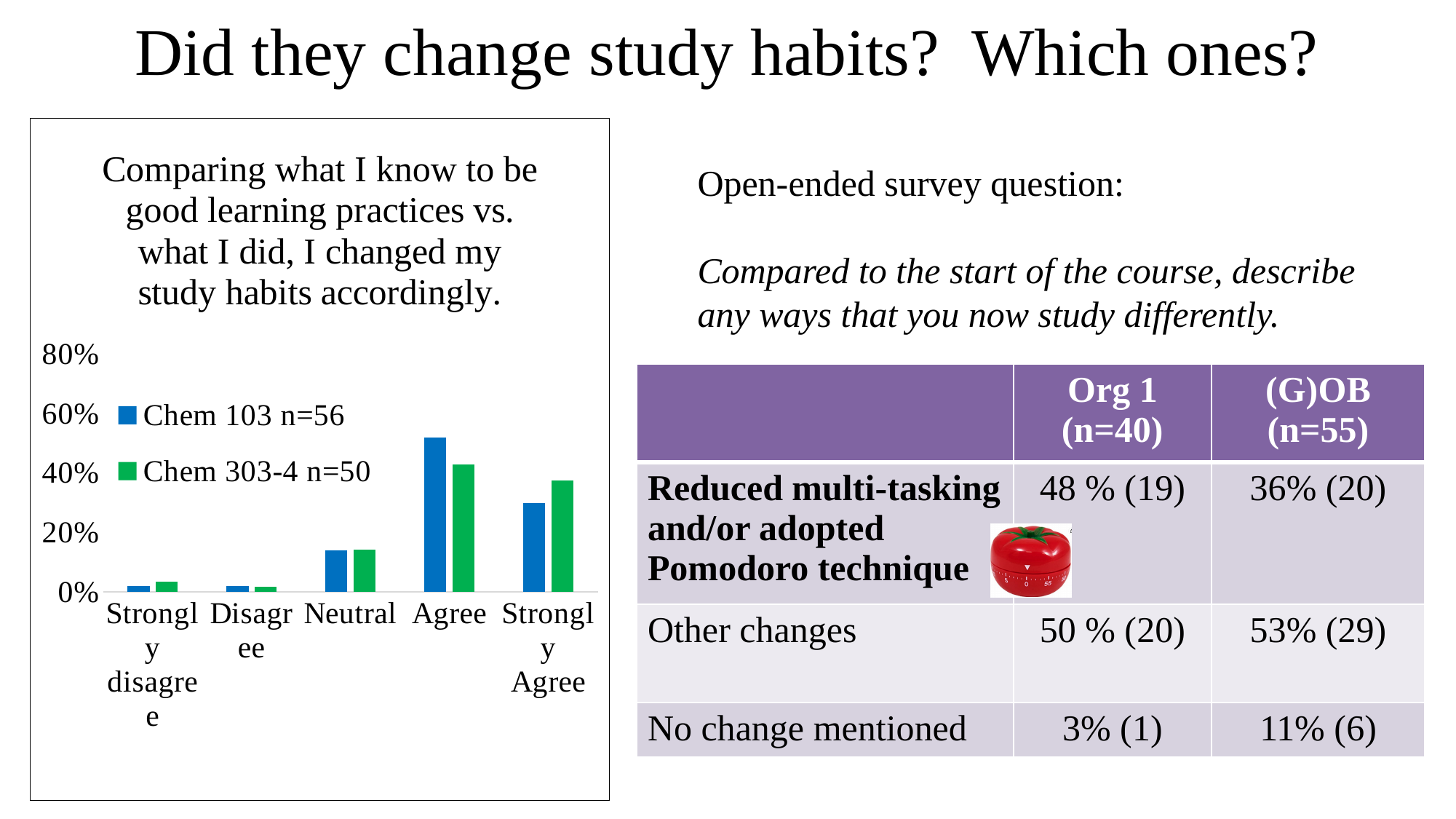
For the Strongly Agree category, which series has the larger value, Chem 103 n=56 or Chem 303-4 n=50? Chem 303-4 n=50 Is the value for Strongly Agree in the Chem 103 n=56 series greater or less than 40%? less For the Agree category, which series has the larger value, Chem 103 n=56 or Chem 303-4 n=50? Chem 103 n=56 How many series does the chart's legend list? 2 Is the value for Neutral in the Chem 303-4 n=50 series greater or less than 20%? less Is the value for Agree in the Chem 103 n=56 series greater or less than 40%? greater How many response categories are shown on the x axis of the chart? 5 Which response category has the highest value for Chem 303-4 n=50? Agree Which response category has the highest value for Chem 103 n=56? Agree Which series in the chart is shown in green? Chem 303-4 n=50 What kind of chart is shown on the slide? bar chart